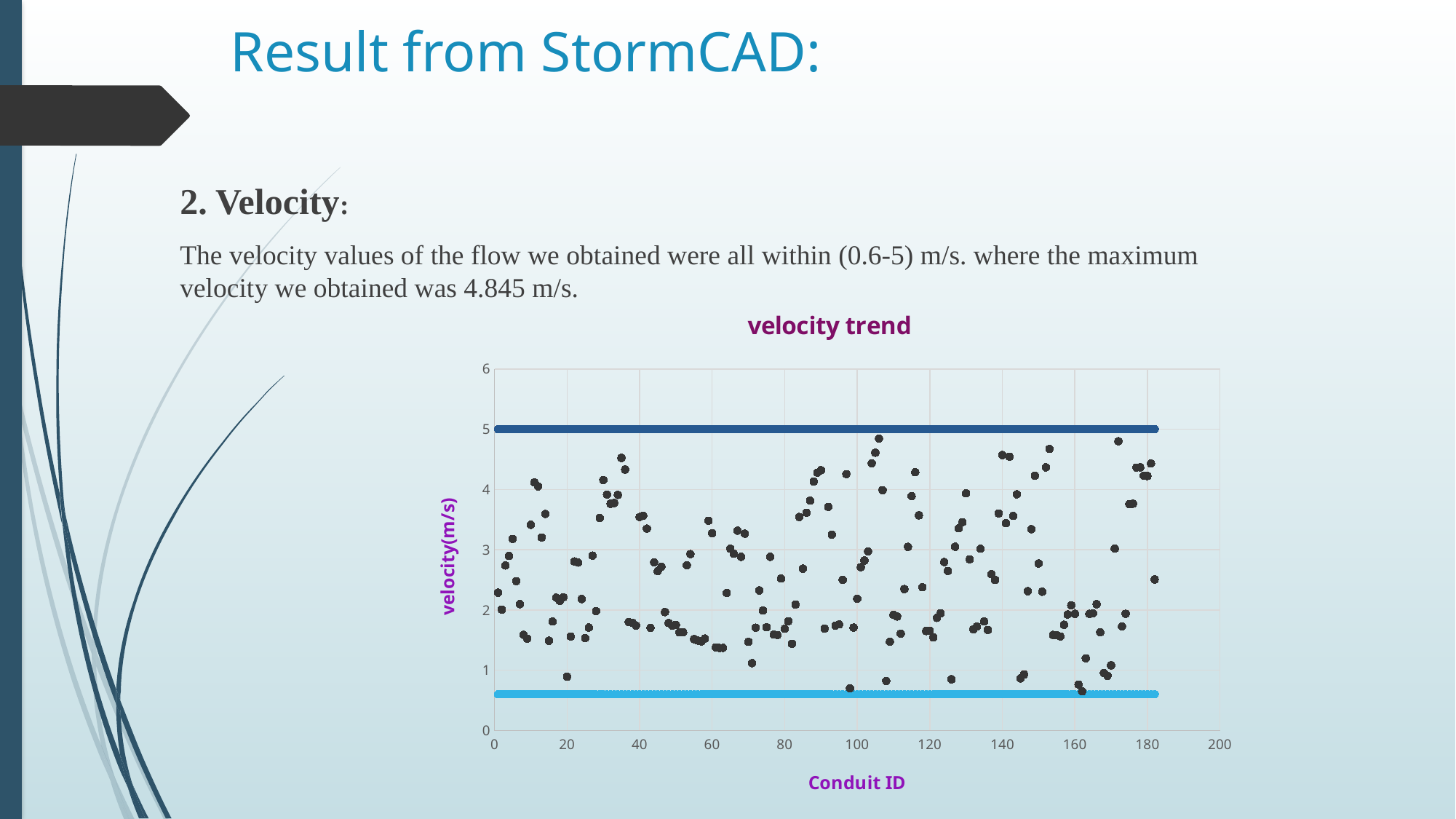
Do the scattered points show a clear rising or falling trend along the Conduit ID axis, or no clear trend? no clear trend What is the highest tick value shown on the horizontal axis? 200 What kind of chart is shown on the slide? scatter chart Are all the scattered velocity points greater or less than 5 m/s? less Is the upper horizontal line greater or less than 4 on the vertical axis? greater At what value on the vertical axis does the upper dark blue horizontal line lie? 5 What is the title of the chart? velocity trend Is the lower light blue horizontal line greater or less than 1 on the vertical axis? less What is the label of the vertical axis of the chart? velocity(m/s) What is the highest tick value shown on the vertical axis? 6